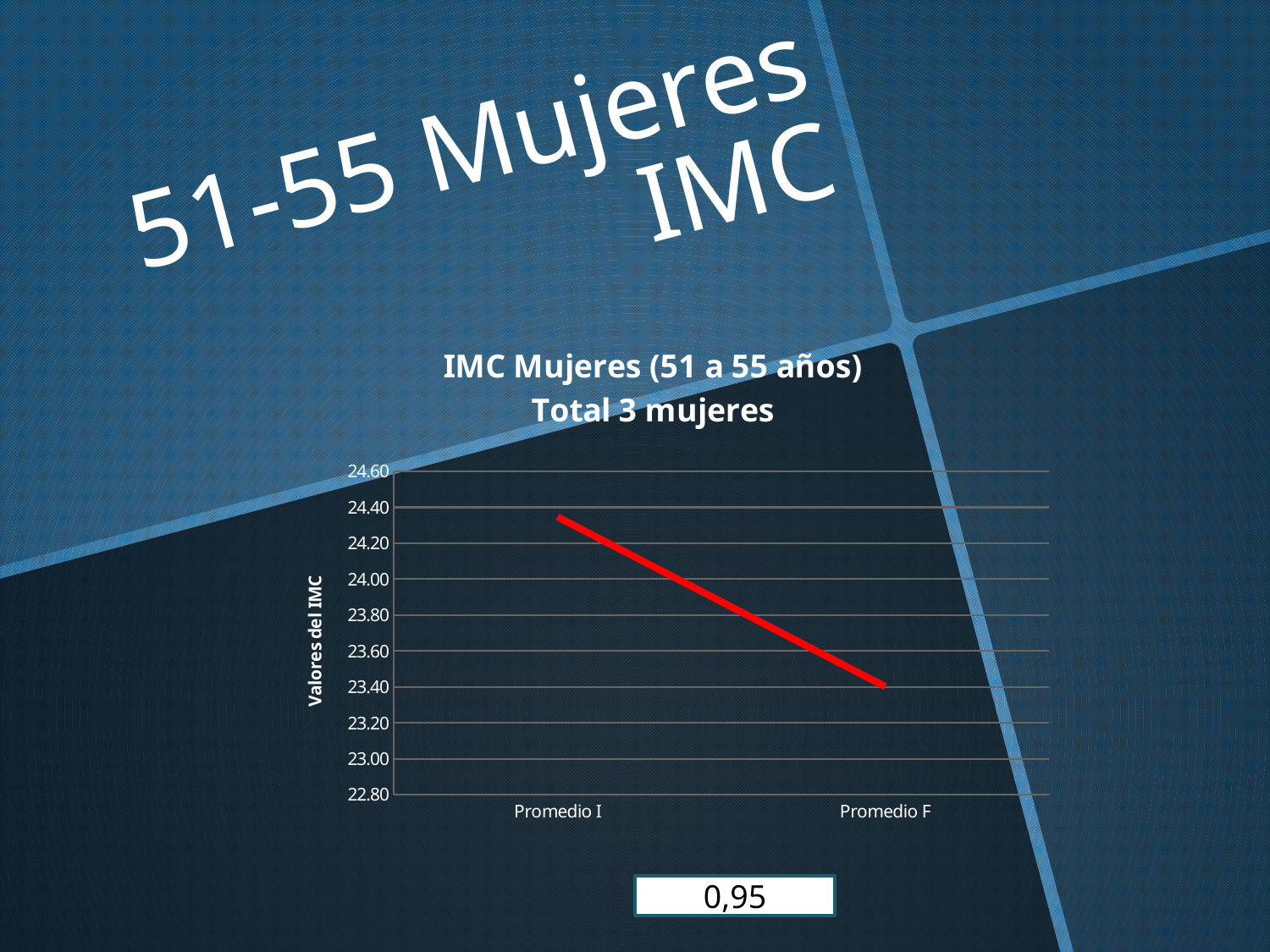
Is the value for Promedio F greater or less than 23.20? greater What kind of chart is shown on the slide? line chart What is the label of the vertical axis? Valores del IMC Which is larger, the value for Promedio I or the value for Promedio F? Promedio I How many points are plotted on the chart? 2 What is the title of the chart? IMC Mujeres (51 a 55 años) Total 3 mujeres Which category has the highest value on the chart? Promedio I Is the value for Promedio I greater or less than 24.20? greater Does the line rise or fall from Promedio I to Promedio F? fall Is the value for Promedio I greater or less than 24.00? greater